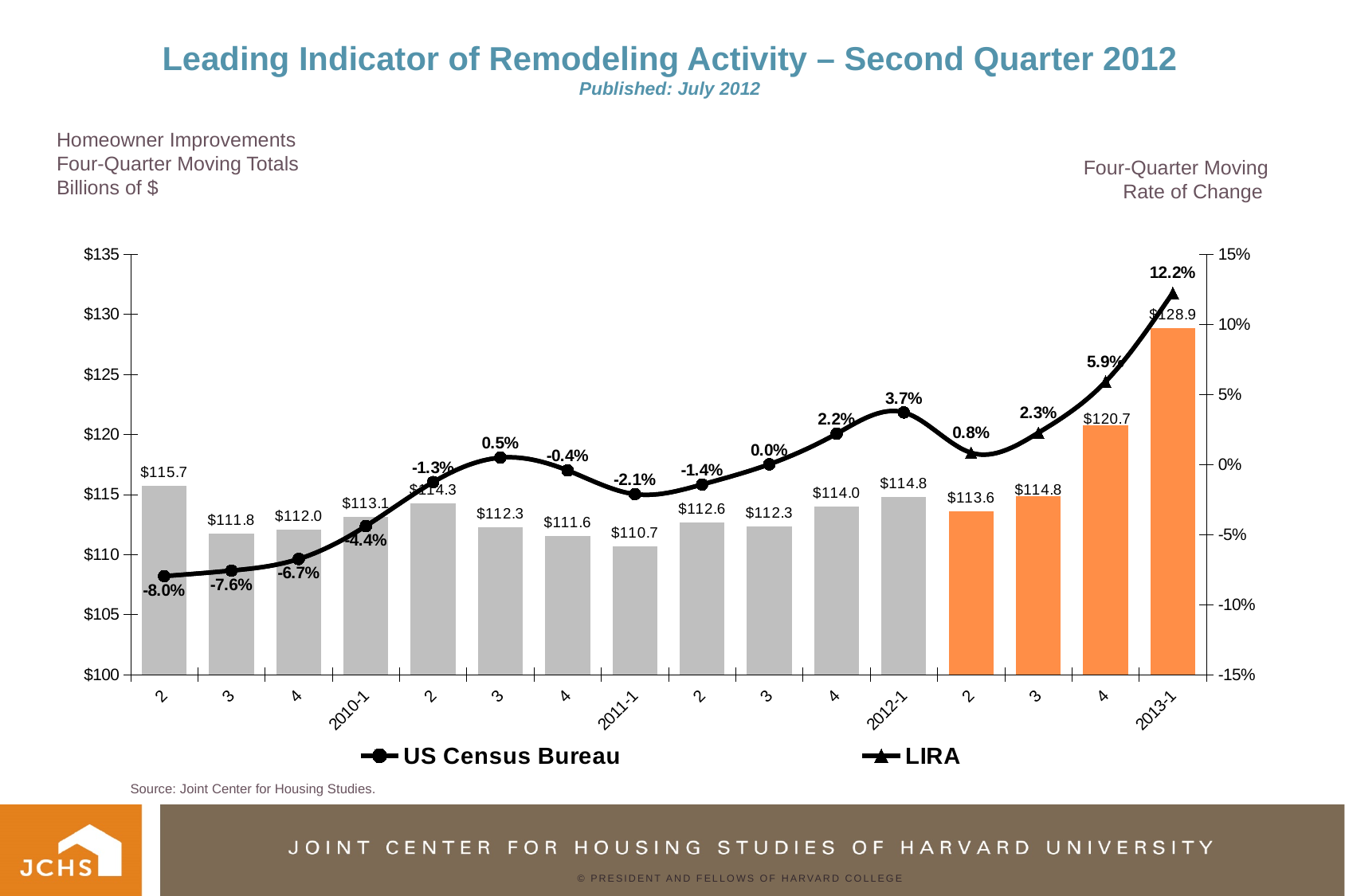
What is the difference between the four-quarter moving totals for 2013-1 and 2012-1? $14.1 What is the four-quarter moving total for 2013-1? $128.9 What are the two series named in the legend? US Census Bureau and LIRA How many bars are plotted in the chart? 16 What is the four-quarter moving rate of change shown for 2013-1? 12.2% How many series does the legend list? 2 What kind of chart is shown on the slide? Combined bar and line chart What is the four-quarter moving total for 2011-1? $110.7 Which is larger, the four-quarter moving total for 2010-1 or for 2011-1? 2010-1 What is the four-quarter moving rate of change shown for 2012-1? 3.7% Which quarter has the lowest four-quarter moving total? 2011-1 Which quarter has the highest four-quarter moving total? 2013-1